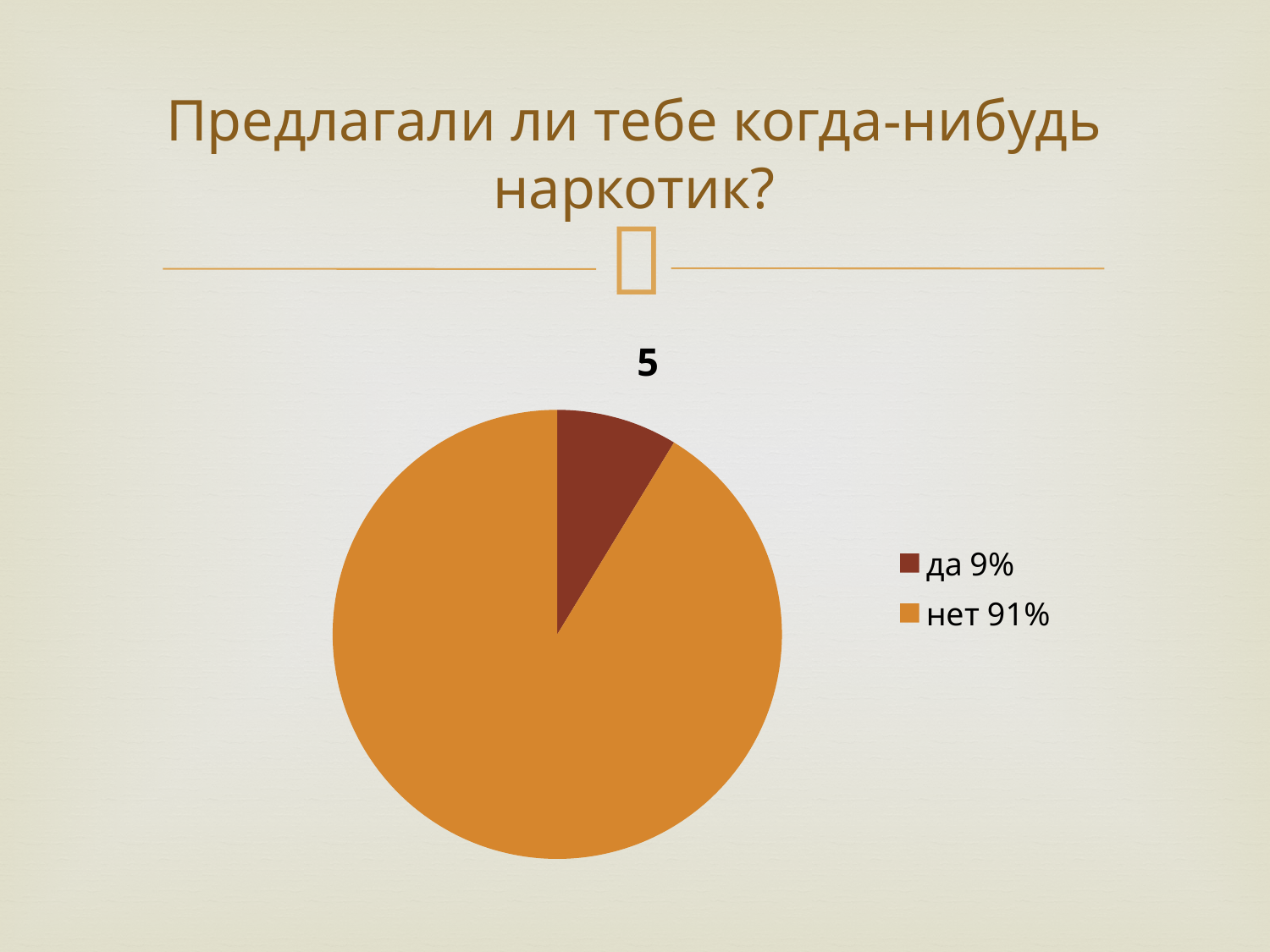
Which slice is the largest? нет Which slice is the smallest? да What colour is the "нет" slice? orange How many slices does the pie chart have? 2 What share of the pie does the "да" slice represent? 9% How many entries does the legend list? 2 Which is larger, the "да" slice or the "нет" slice? нет What share of the pie does the "нет" slice represent? 91% What question does the slide heading ask? Предлагали ли тебе когда-нибудь наркотик? What kind of chart is shown on the slide? pie chart What is the difference in percentage points between the "нет" and "да" slices? 82 What is the chart's title? 5